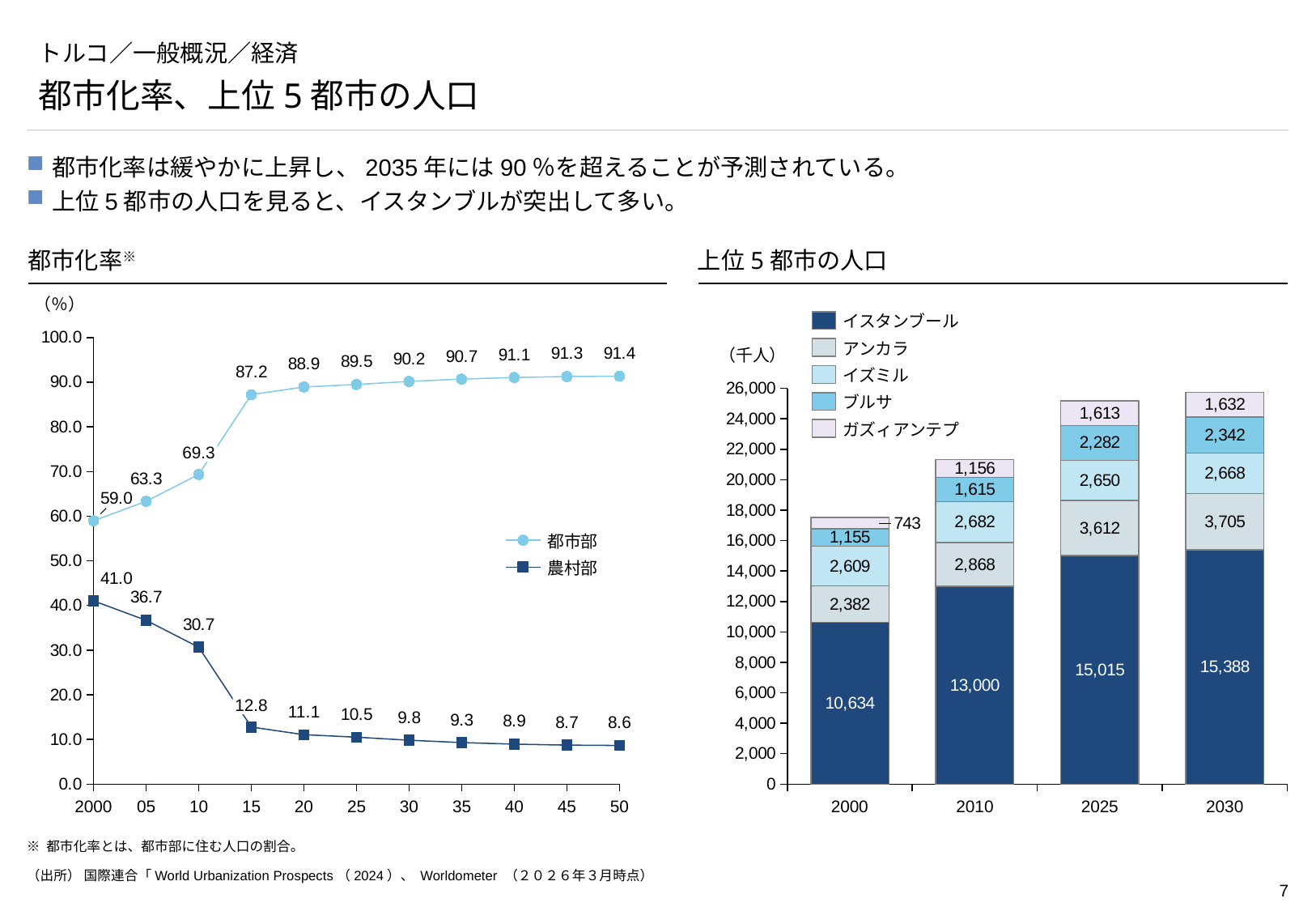
What kind of chart is the 都市化率 chart? line chart In the 都市化率 chart, what is the 農村部 value for 15 (2015)? 12.8 In the 上位5都市の人口 chart, which is larger in 2025: アンカラ or イズミル? アンカラ In the 上位5都市の人口 chart, how many series does the legend list? 5 In the 都市化率 chart, how many series does the legend list? 2 In the 上位5都市の人口 chart, what is the value for ガズィアンテプ in 2000? 743 In the 上位5都市の人口 chart, which year has the highest value for イスタンブール? 2030 In the 上位5都市の人口 chart, what is the total of the stacked bar for 2030? 25,735 In the 都市化率 chart, what is the difference between the 都市部 and 農村部 values for 50 (2050)? 82.8 In the 都市化率 chart, does the 都市部 line rise or fall from 2000 to 50? rise In the 都市化率 chart, what is the 都市部 value for 2000? 59.0 In the 上位5都市の人口 chart, what is the value for イスタンブール in 2010? 13,000